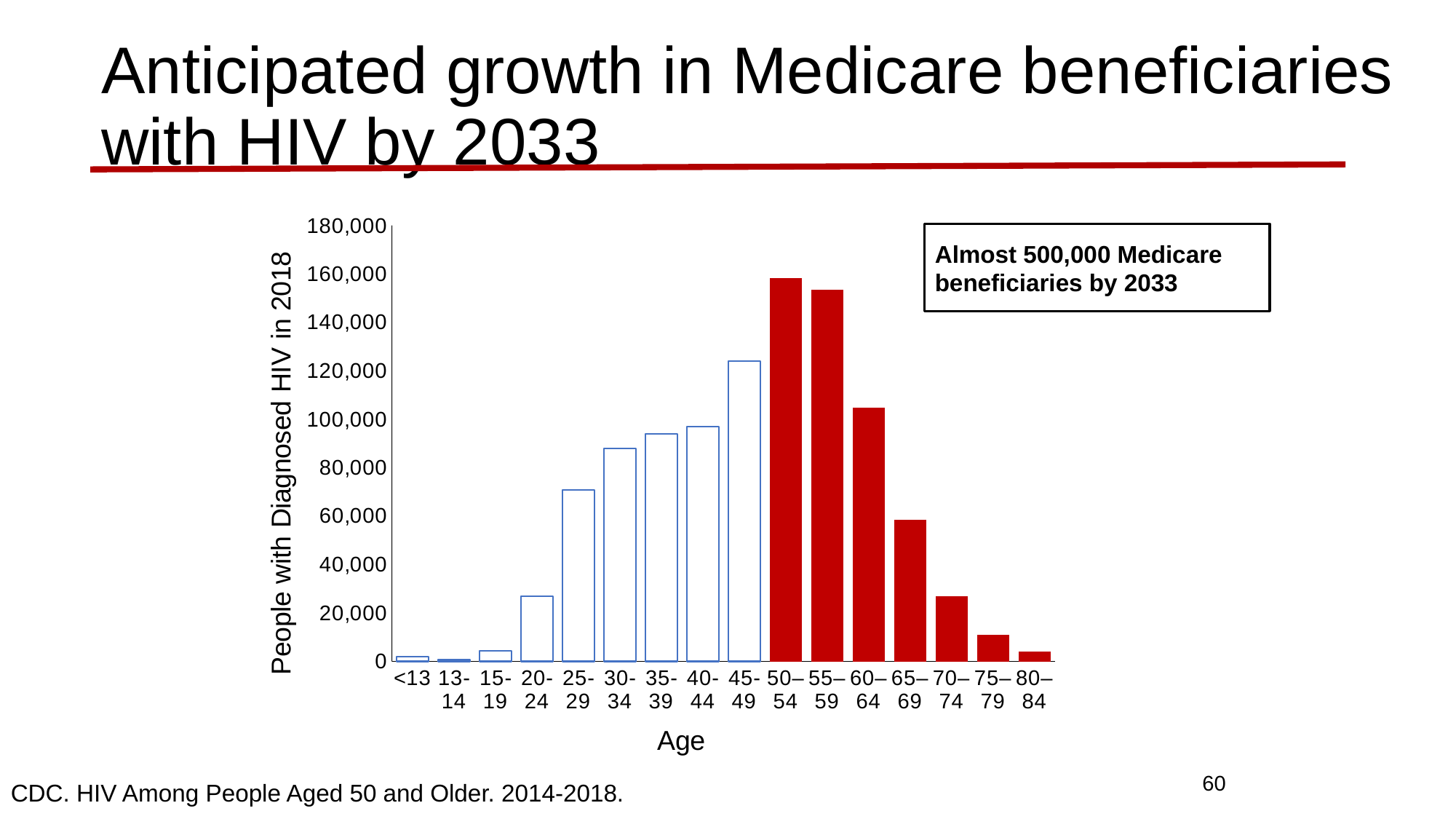
What kind of chart is shown on the slide? bar chart Is the value for the 75–79 age group greater or less than 20,000? less Is the value for the 35-39 age group greater or less than 100,000? less Is the value for the 30-34 age group greater or less than 80,000? greater What is the title of the vertical axis of the chart? People with Diagnosed HIV in 2018 Which age group has a larger value, 45-49 or 60–64? 45-49 How many age categories are shown on the x axis of the chart? 16 Which age group has a larger value, 25-29 or 65–69? 25-29 Do the values rise or fall along the x axis from the 50–54 age group to the 80–84 age group? fall Which age group has the highest number of people with diagnosed HIV in 2018? 50–54